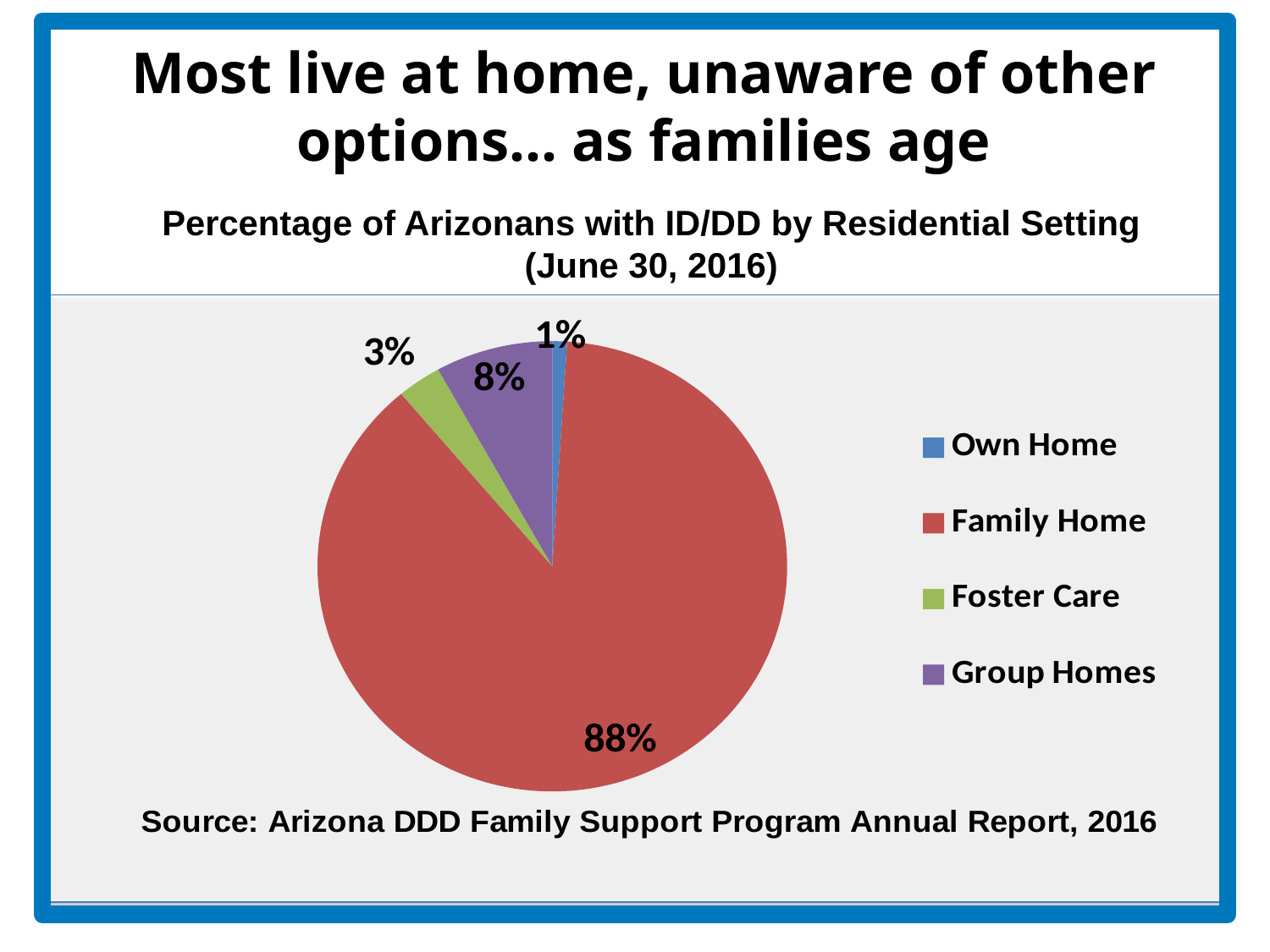
What colour represents Foster Care in the pie chart? Green How many residential settings are shown in the pie chart? 4 What percentage of Arizonans with ID/DD live in Group Homes? 8% What kind of chart is shown on the slide? Pie chart Which is larger, the share for Foster Care or the share for Group Homes? Group Homes What percentage of Arizonans with ID/DD live in Foster Care? 3% Which residential setting has the largest share of the pie? Family Home What is the difference in percentage points between Family Home and Group Homes? 80 What percentage of Arizonans with ID/DD live in a Family Home? 88% What is the title of the pie chart? Percentage of Arizonans with ID/DD by Residential Setting (June 30, 2016) Which residential setting has the smallest share of the pie? Own Home What percentage of Arizonans with ID/DD live in their Own Home? 1%